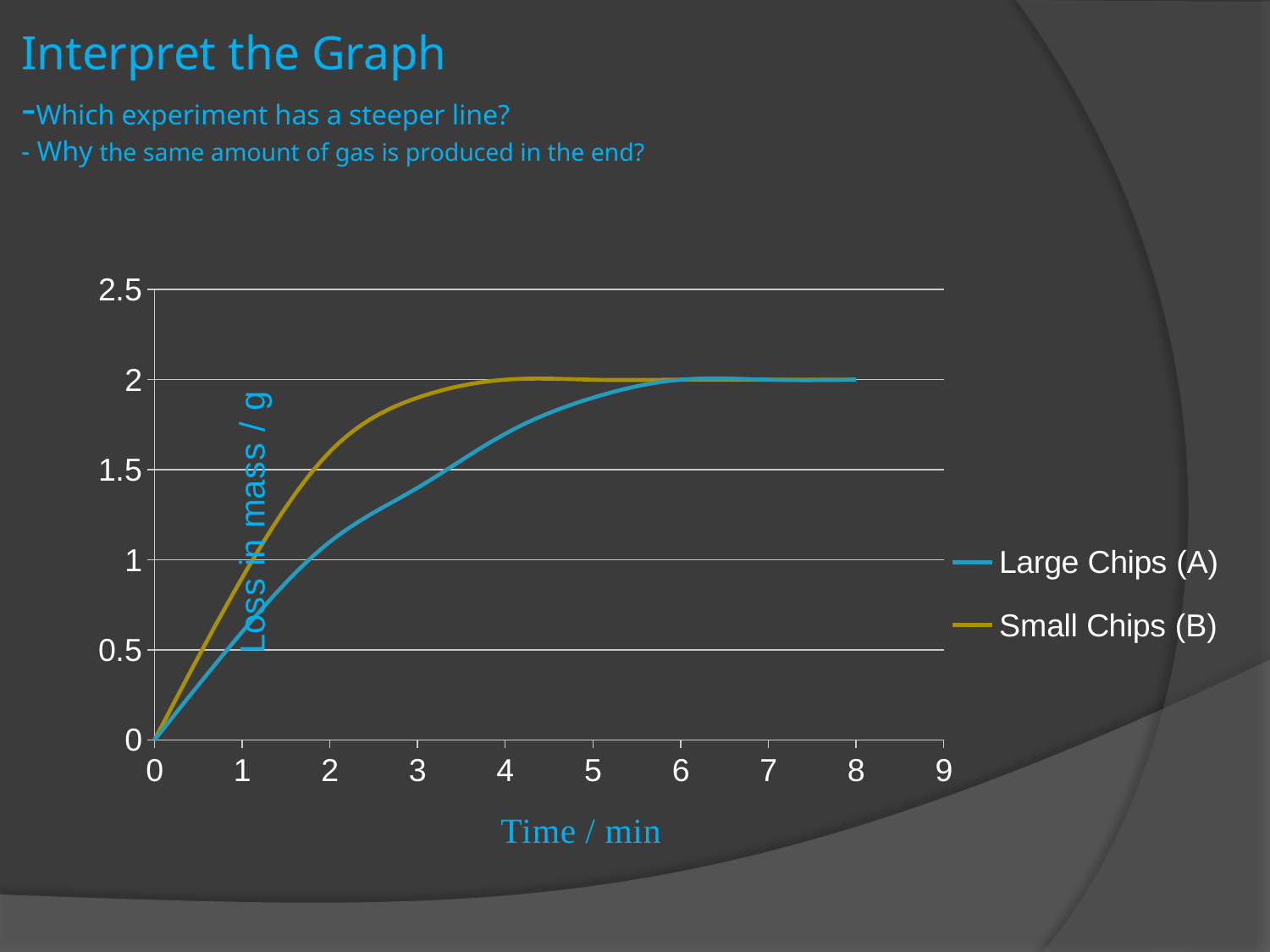
Do the values for Large Chips (A) rise or fall as time increases from 0 to 4 min? rise Is the value for Large Chips (A) at 5 min greater or less than 1.5? greater What is the loss in mass for both series at time 0? 0 Is the value for Small Chips (B) at 2 min greater or less than 1.5? greater What are the two series named in the legend? Large Chips (A) and Small Chips (B) What kind of chart is shown on the slide? line chart What value do both lines level off at? 2 Is the value for Large Chips (A) at 2 min greater or less than 1.5? less At 2 min, which series has the higher loss in mass? Small Chips (B) What is the title of the x axis? Time / min Which series reaches the plateau of 2 g first? Small Chips (B) How many series does the legend list? 2